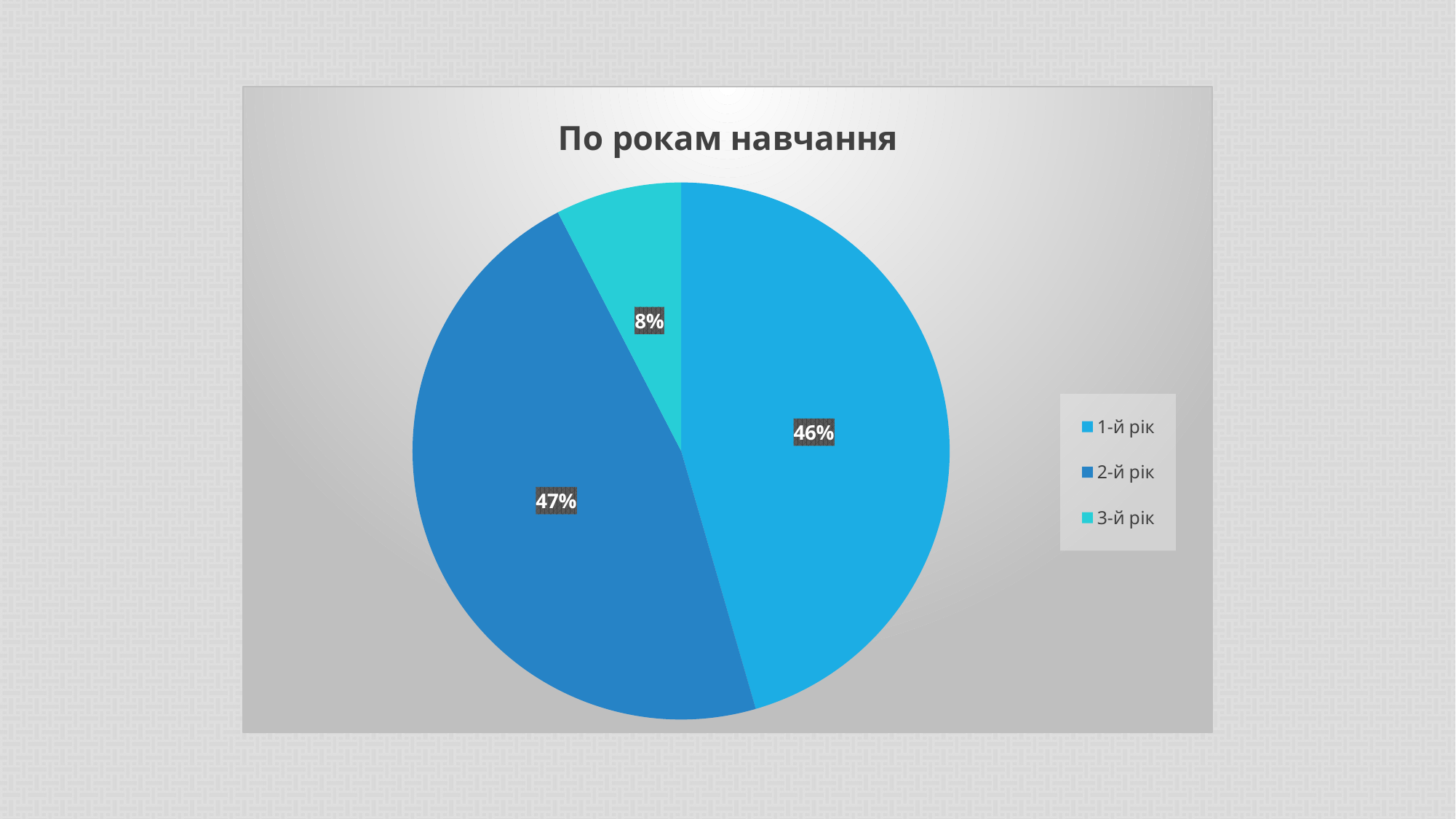
What is the difference in percentage points between the 2-й рік and 1-й рік slices? 1 How many slices does the pie chart have? 3 What is the share of the pie for 2-й рік? 47% Which category has the smallest slice of the pie? 3-й рік What is the title of the chart? По рокам навчання Which slice is larger, 1-й рік or 3-й рік? 1-й рік How many entries does the legend list? 3 What kind of chart is shown on the slide? pie chart What is the share of the pie for 3-й рік? 8% Which category has the largest slice of the pie? 2-й рік What is the difference in percentage points between the 1-й рік and 3-й рік slices? 38 What is the share of the pie for 1-й рік? 46%